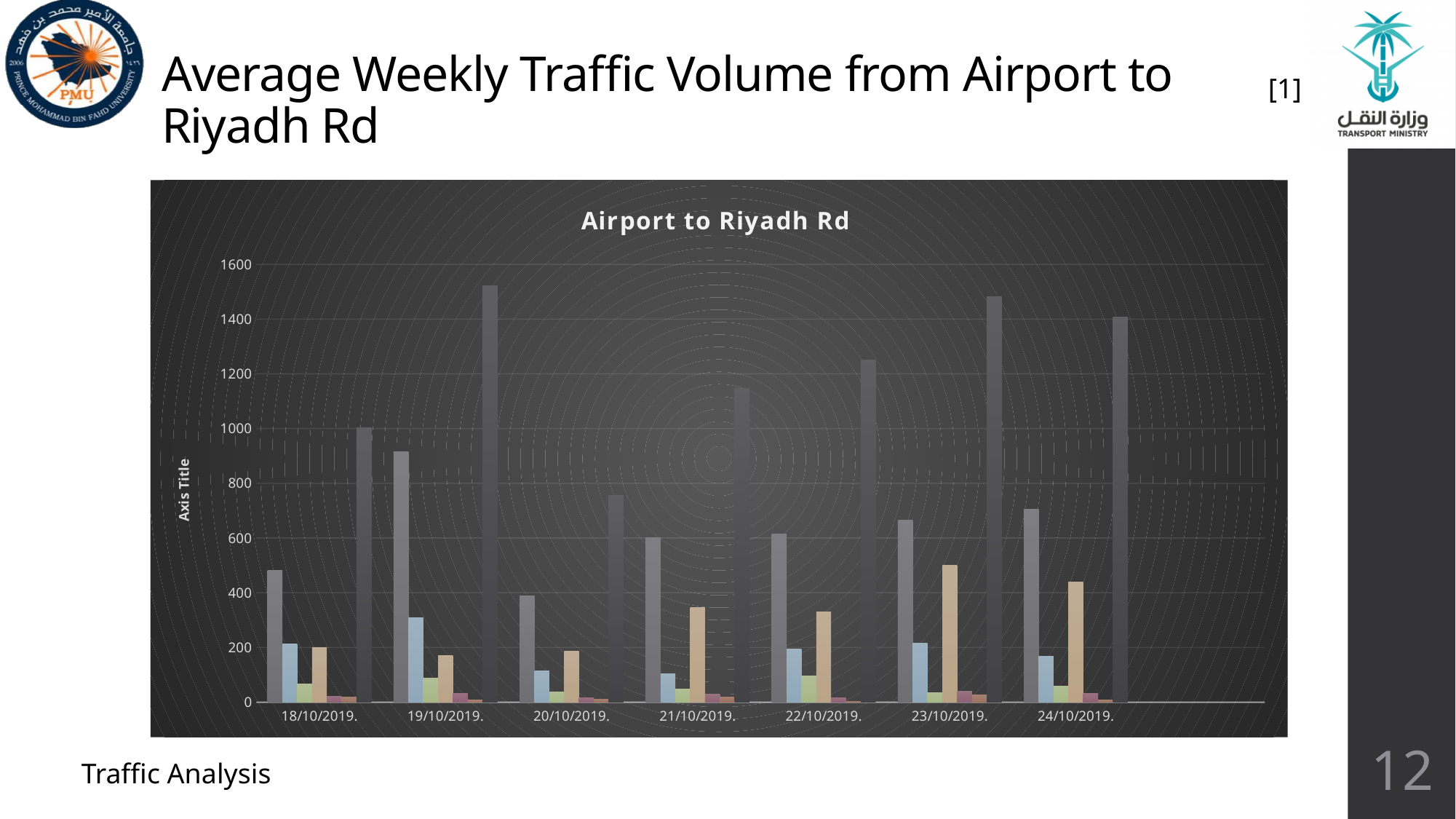
Is the tallest bar for 22/10/2019 greater or less than 1000? greater What kind of chart is shown on the slide? bar chart Is the tallest bar for 21/10/2019 greater or less than 1000? greater What is the title of the chart? Airport to Riyadh Rd Is the tallest bar for 19/10/2019 greater or less than 1400? greater What label is shown on the vertical axis of the chart? Axis Title On which date does the chart show the tallest bar overall? 19/10/2019 How many dates are shown along the x axis of the chart? 7 Which date has the taller tallest bar, 18/10/2019 or 23/10/2019? 23/10/2019 Which date has the taller tallest bar, 19/10/2019 or 21/10/2019? 19/10/2019